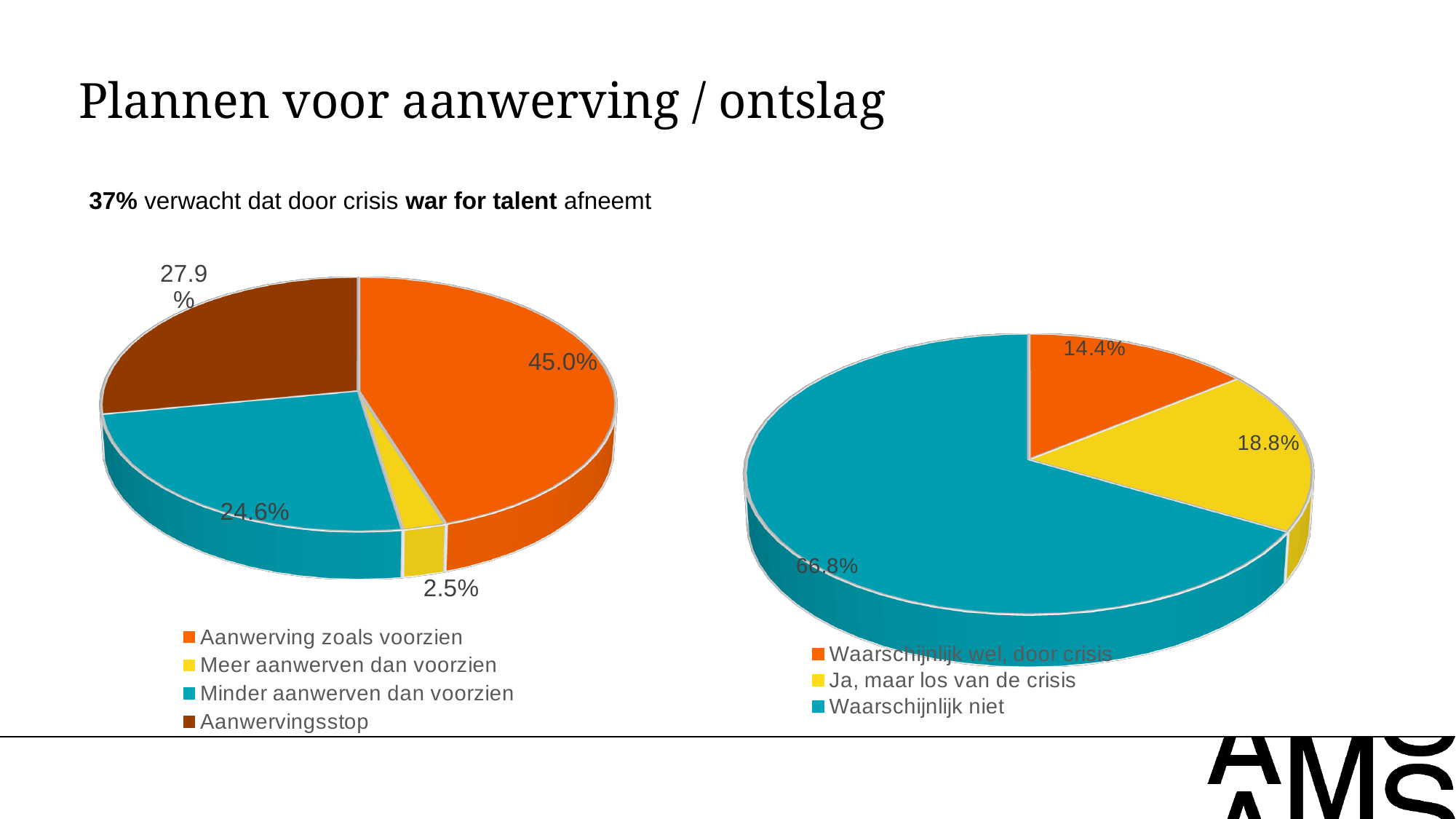
In the left pie chart, how many categories does the legend list? 4 In the left pie chart, what share is labelled for 'Aanwerving zoals voorzien'? 45.0% In the right pie chart, what share is labelled for 'Waarschijnlijk niet'? 66.8% In the right pie chart, which colour represents 'Waarschijnlijk niet'? Teal (blue-green) In the right pie chart, which is larger: 'Waarschijnlijk wel, door crisis' or 'Ja, maar los van de crisis'? Ja, maar los van de crisis In the left pie chart, which category has the largest slice? Aanwerving zoals voorzien In the left pie chart, what is the difference between the shares for 'Aanwervingsstop' and 'Minder aanwerven dan voorzien'? 3.3% In the left pie chart, what share is labelled for 'Aanwervingsstop'? 27.9% What kind of chart is the chart on the left of the slide? Pie chart In the left pie chart, what share is labelled for 'Meer aanwerven dan voorzien'? 2.5% In the left pie chart, which category has the smallest slice? Meer aanwerven dan voorzien In the right pie chart, what share is labelled for 'Ja, maar los van de crisis'? 18.8%